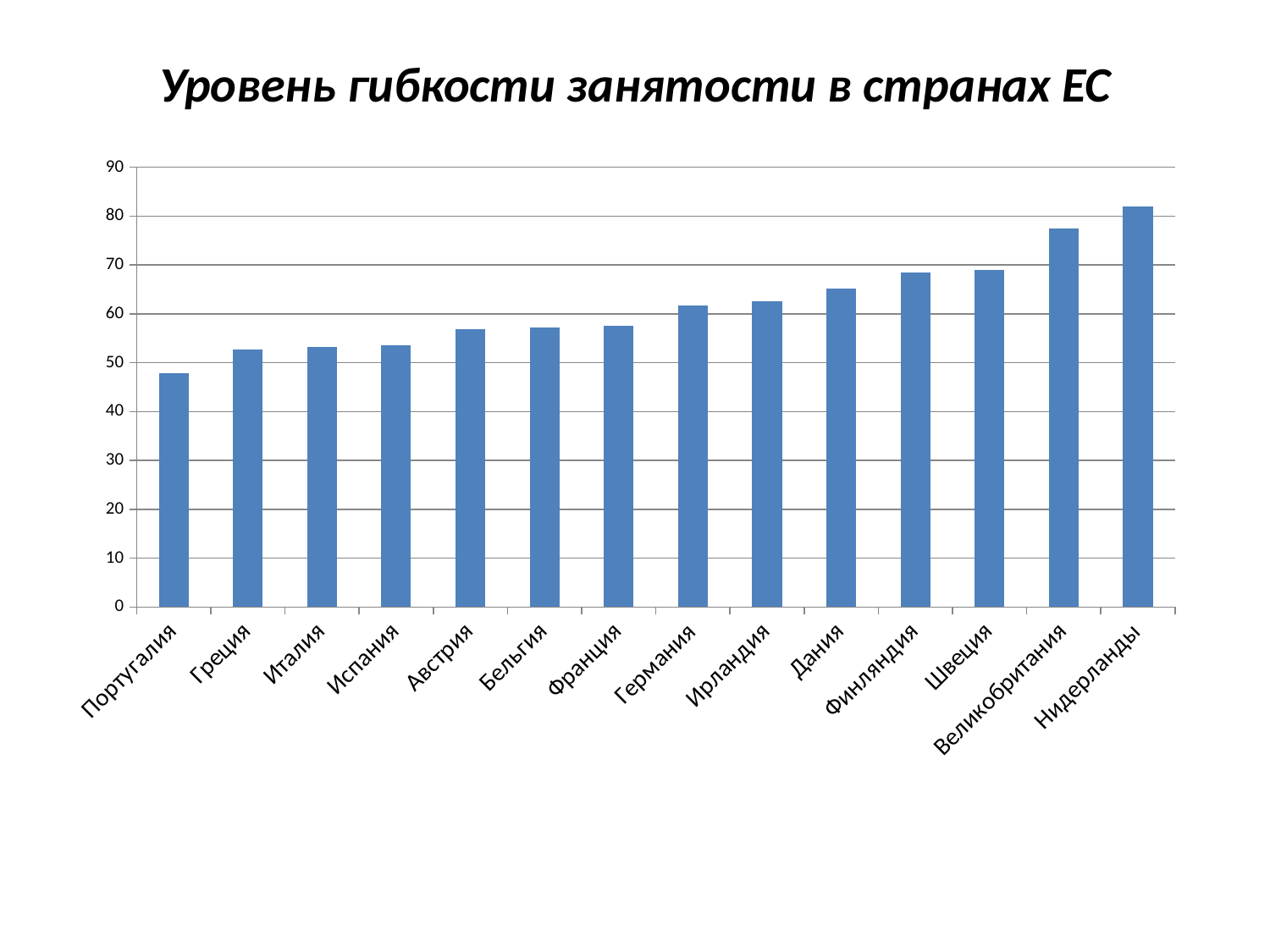
Is the value for Финляндия greater or less than 70? less Which has a larger value, Дания or Греция? Дания Is the value for Нидерланды greater or less than 80? greater Is the value for Дания greater or less than 60? greater Which country has the highest value on the chart? Нидерланды Which country has the lowest value on the chart? Португалия How many countries are shown on the chart? 14 Do the values rise or fall from left to right along the x axis? rise What kind of chart is shown on the slide? bar chart What is the title of the chart? Уровень гибкости занятости в странах ЕС